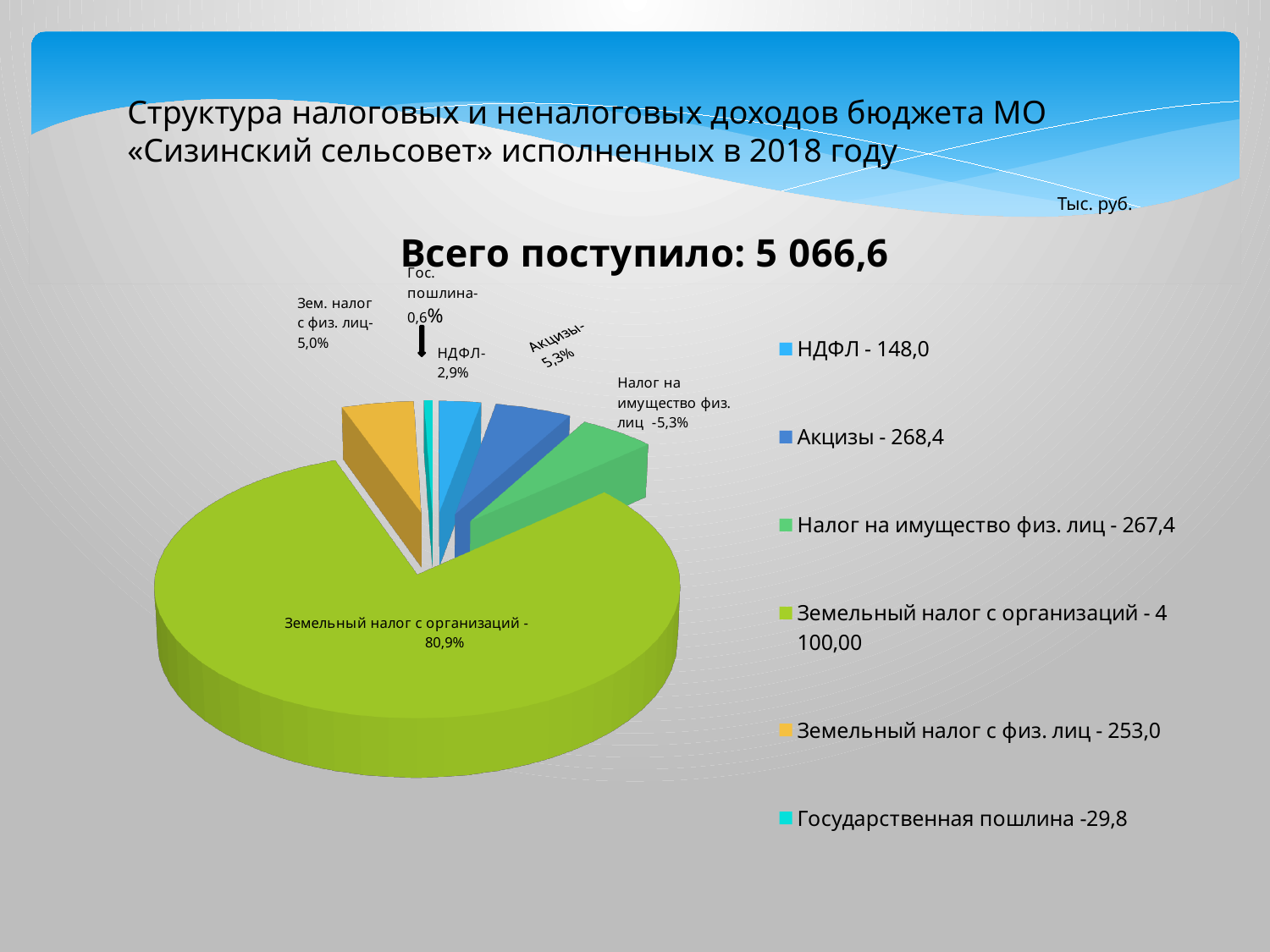
Which category has the smallest share of the pie? Государственная пошлина Which category has the largest share of the pie? Земельный налог с организаций According to the legend, what is the value for Земельный налог с физ. лиц? 253,0 How many slices does the pie chart have? 6 What share of the pie does Земельный налог с организаций have? 80,9% What share of the pie does Акцизы have? 5,3% What share of the pie does НДФЛ have? 2,9% What kind of chart is shown on the slide? pie chart What total amount is stated in the chart title? 5 066,6 According to the legend, what is the value for Акцизы? 268,4 What is the difference between the legend values for Акцизы and НДФЛ? 120,4